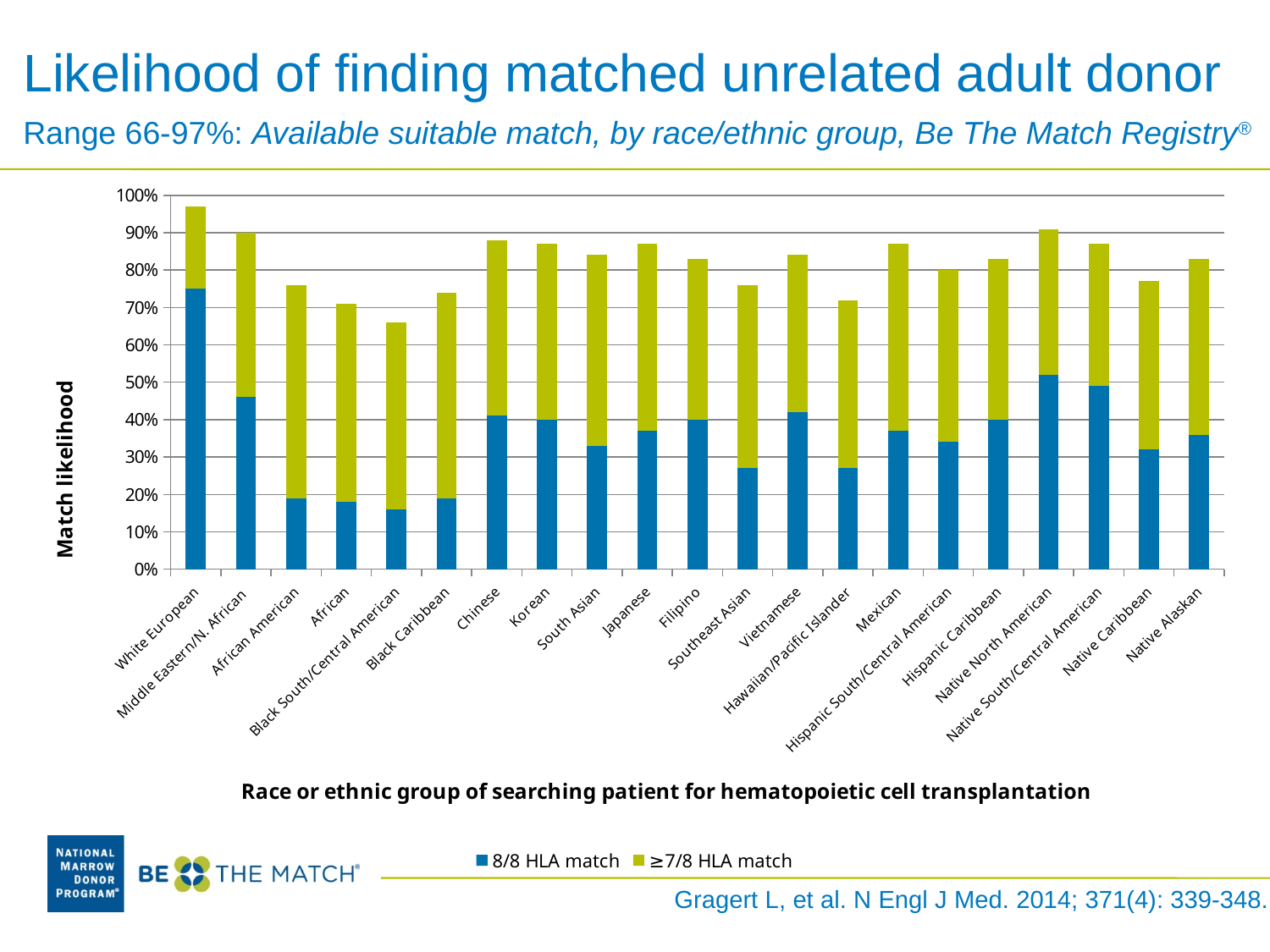
Is the 8/8 HLA match value for White European greater or less than 70%? greater What kind of chart is shown on the slide? Stacked bar chart Is the 8/8 HLA match value for Korean greater or less than 50%? less Which has the larger 8/8 HLA match value, White European or Middle Eastern/N. African? White European Is the 8/8 HLA match value for Black South/Central American greater or less than 20%? less Which race/ethnic group has the lowest total match likelihood? Black South/Central American How many race/ethnic groups are shown along the x axis? 21 How many series does the legend list? 2 What is the label on the vertical axis of the chart? Match likelihood Which race/ethnic group has the highest total match likelihood? White European Which has the larger total match likelihood, Chinese or Southeast Asian? Chinese